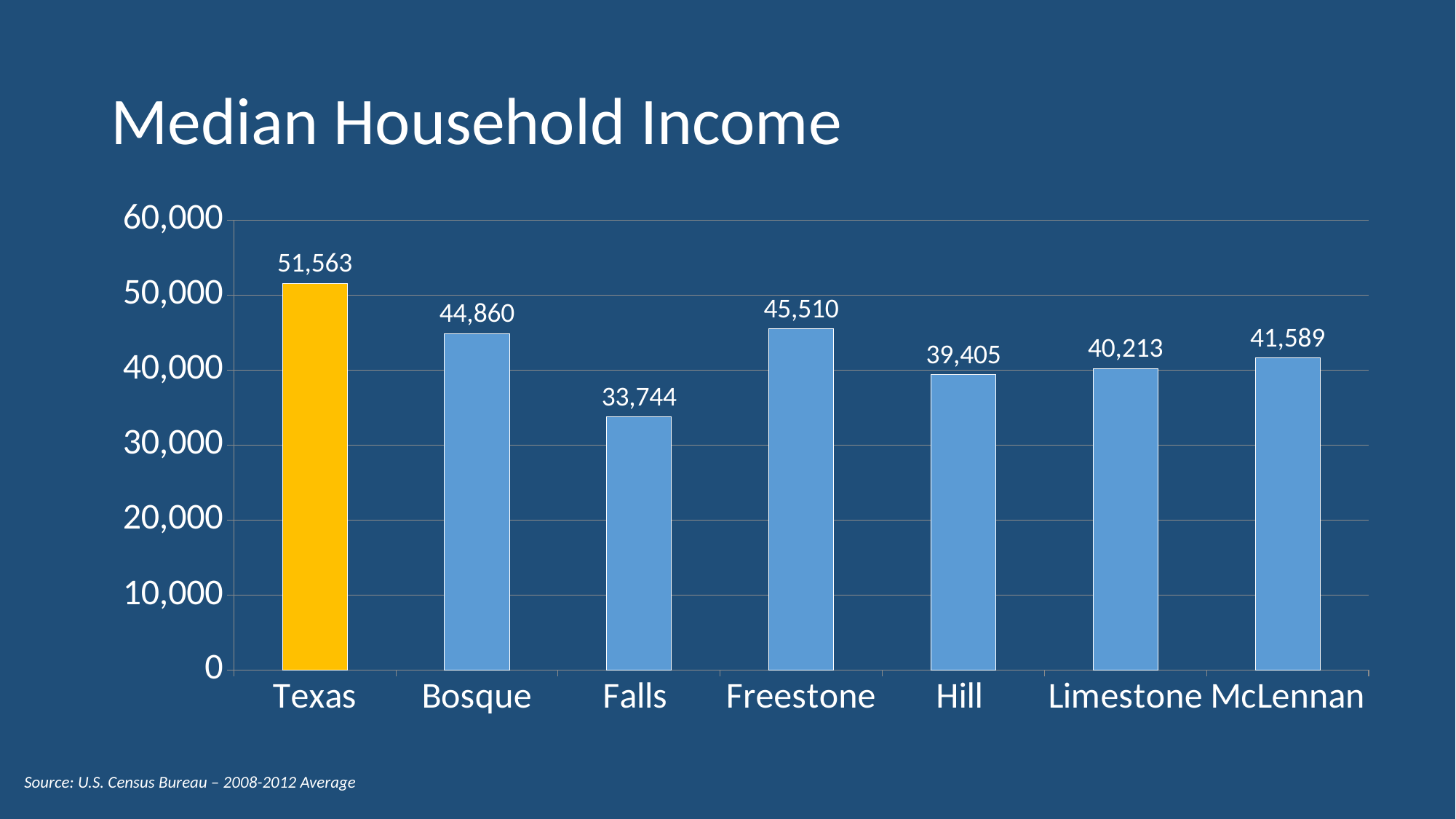
How many categories are shown on the chart? 7 What is the median household income for Limestone? 40,213 Which bar is coloured differently from the others? Texas Which category has the highest median household income? Texas Which category has the lowest median household income? Falls What is the median household income for Falls? 33,744 Is the value for Hill greater or less than 40,000? less Which has a higher median household income, Freestone or Bosque? Freestone What is the difference between the median household income of McLennan and Hill? 2,184 What kind of chart is shown on the slide? bar chart What is the difference between the median household income of Texas and Bosque? 6,703 What is the median household income for Texas? 51,563